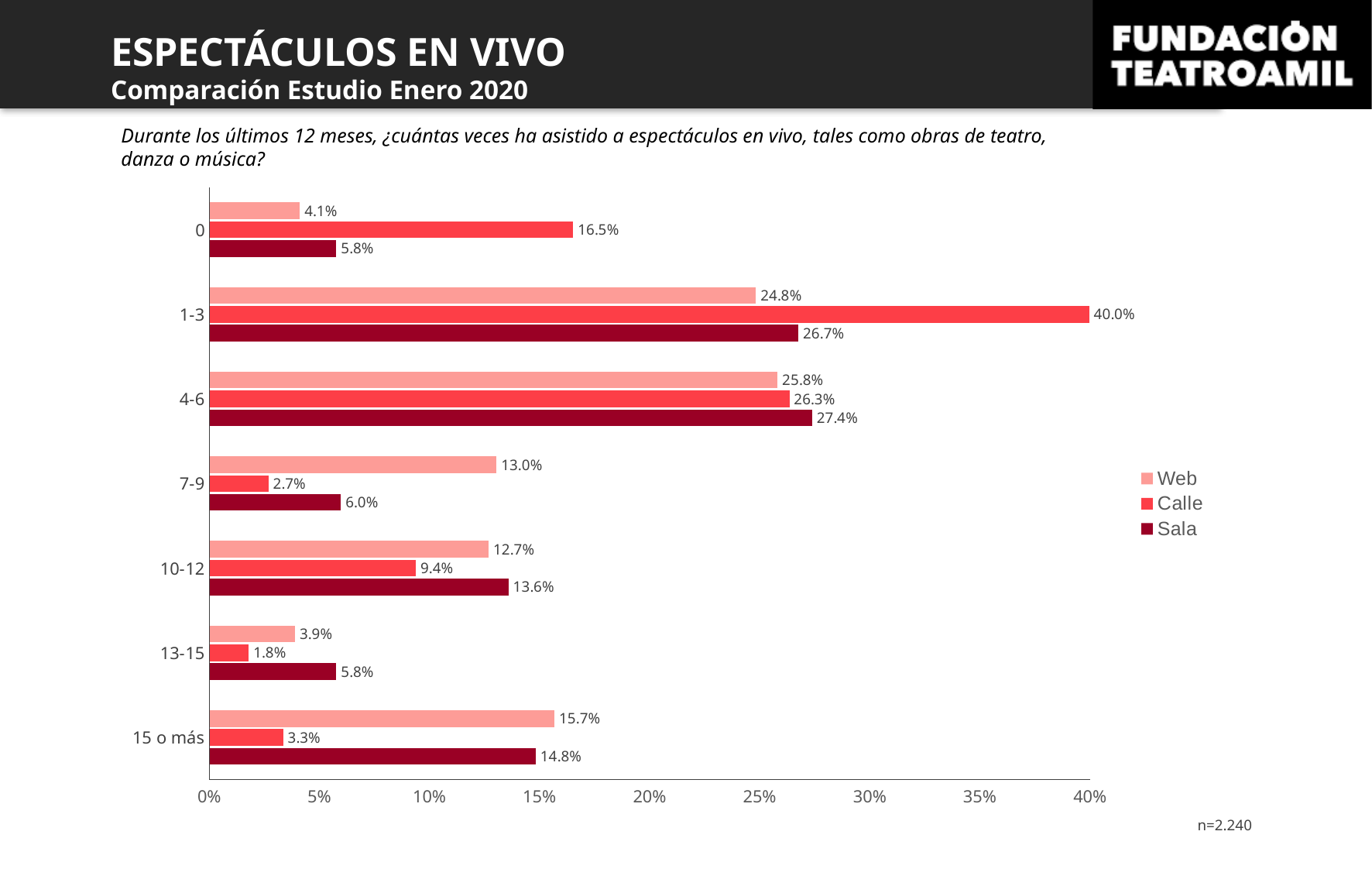
What is the difference between the Calle and Web values in the 0 category? 12.4% What is the value for Calle in the 1-3 category? 40.0% Which category has the lowest value for the Calle series? 13-15 What kind of chart is shown on the slide? Bar chart What is the value for Sala in the 4-6 category? 27.4% How many categories are shown on the vertical axis? 7 What are the three series named in the legend? Web, Calle, Sala How many series does the legend list? 3 Which category has the highest value for the Calle series? 1-3 Is the value for Sala in the 1-3 category greater or less than 25%? greater Which is larger in the 7-9 category, Web or Sala? Web What is the value for Web in the 15 o más category? 15.7%